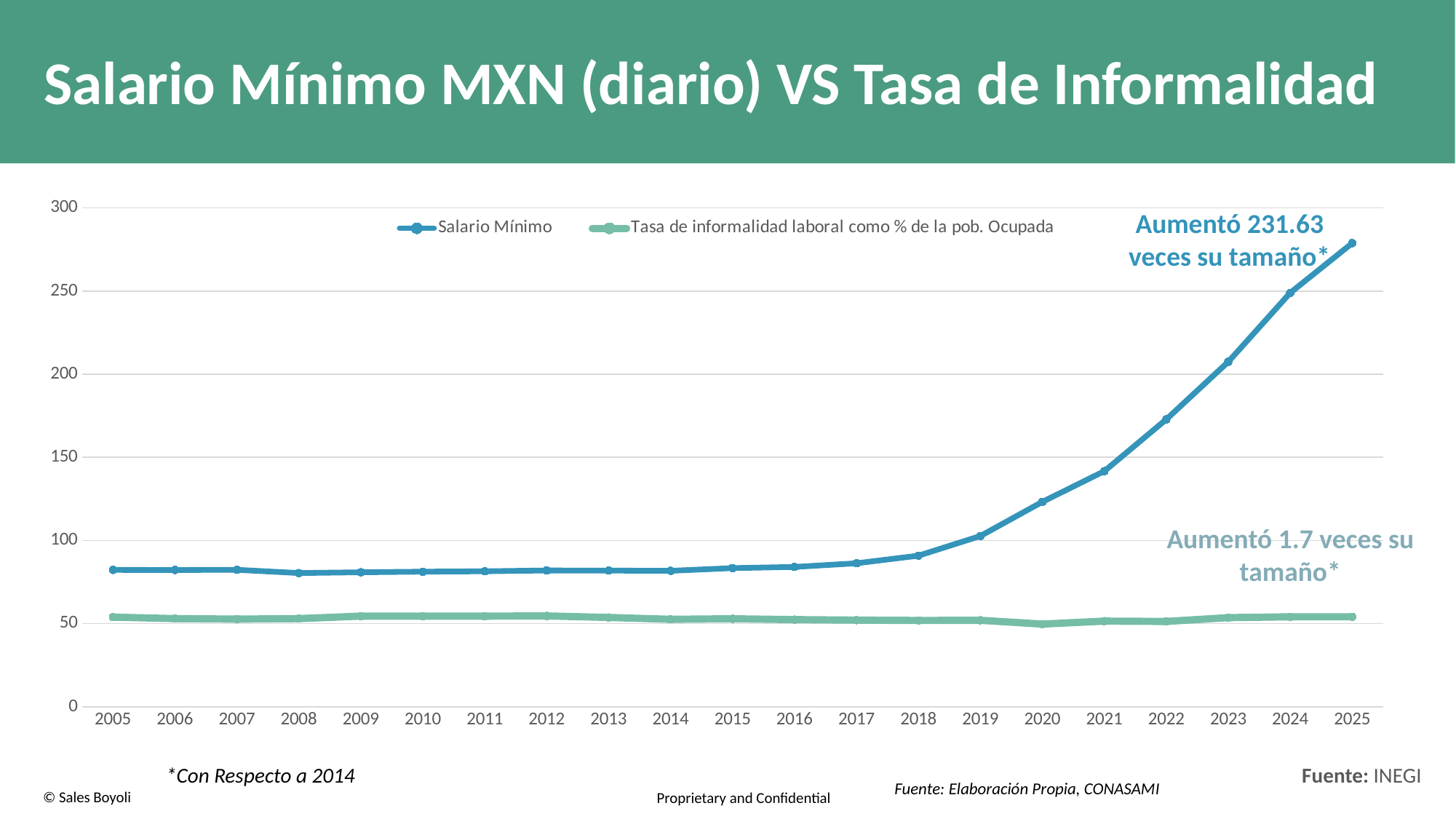
Is the value for Salario Mínimo in 2021 greater or less than 150? less Does the Salario Mínimo series rise or fall between 2018 and 2025? Rise Which is larger in 2015: Salario Mínimo or Tasa de informalidad laboral como % de la pob. Ocupada? Salario Mínimo What is the title of the chart? Salario Mínimo MXN (diario) VS Tasa de Informalidad How many series does the legend list? 2 What kind of chart is shown on the slide? Line chart Is the value for Salario Mínimo in 2022 greater or less than 150? greater Is the value for Salario Mínimo in 2025 greater or less than 250? greater According to the annotation, by how many times did the Salario Mínimo increase with respect to 2014? 231.63 veces In which year is the Salario Mínimo series at its highest? 2025 How many years are shown along the x axis? 21